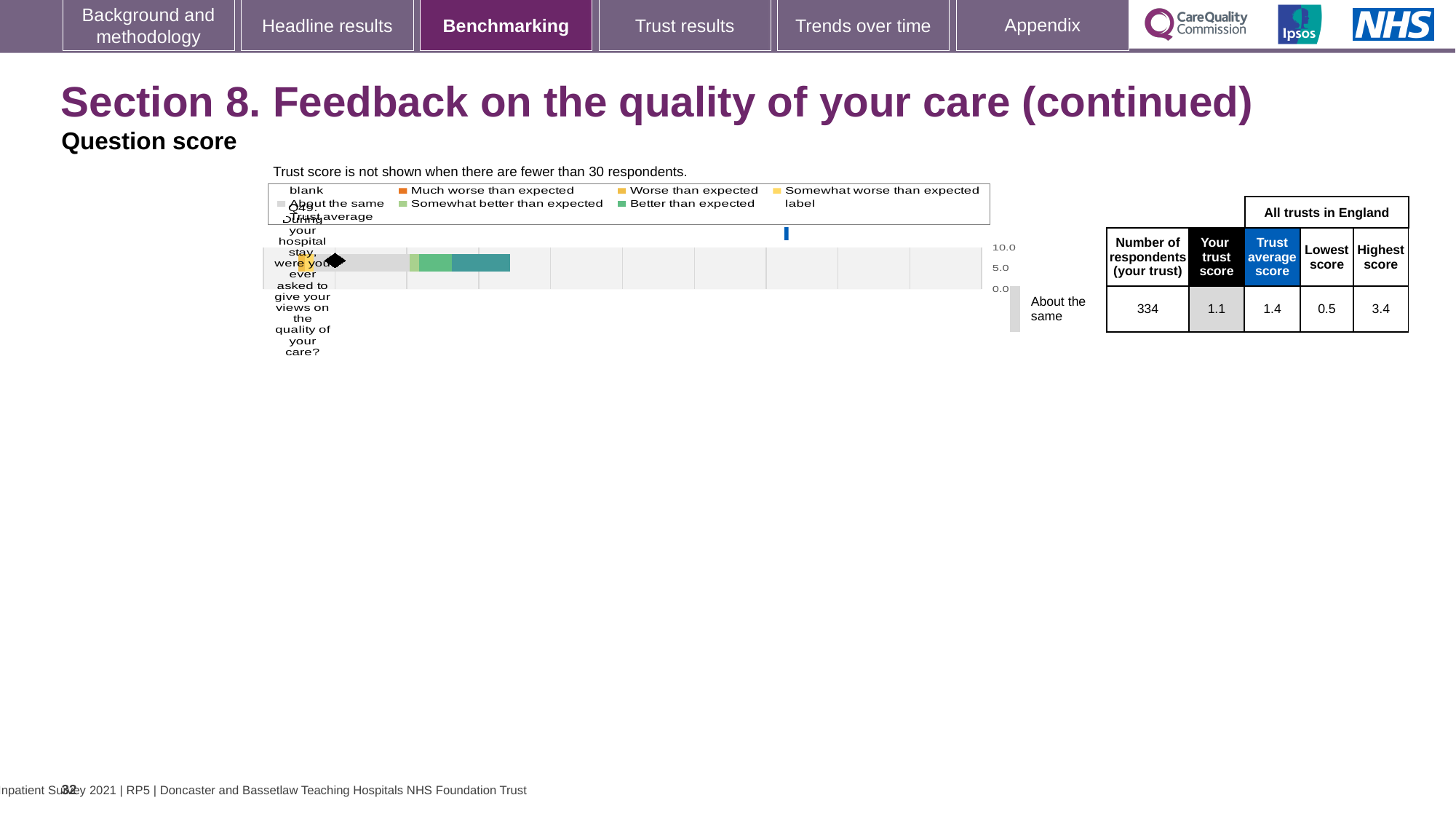
What colour does the legend use for 'Much worse than expected'? Orange According to the note above the chart, below how many respondents is the trust score not shown? 30 In the table next to the chart, what is your trust score for Q49? 1.1 What kind of chart is shown on the slide? Bar chart In the table next to the chart, what is the number of respondents for your trust? 334 In the table next to the chart, what is the highest score among all trusts in England? 3.4 How many entries does the chart legend list? 9 What is the difference between the highest score and the lowest score among all trusts in England? 2.9 In the table next to the chart, what is the trust average score? 1.4 How many question categories are plotted in the bar chart? 1 In the table next to the chart, what is the lowest score among all trusts in England? 0.5 Which is larger, your trust score or the trust average score? Trust average score